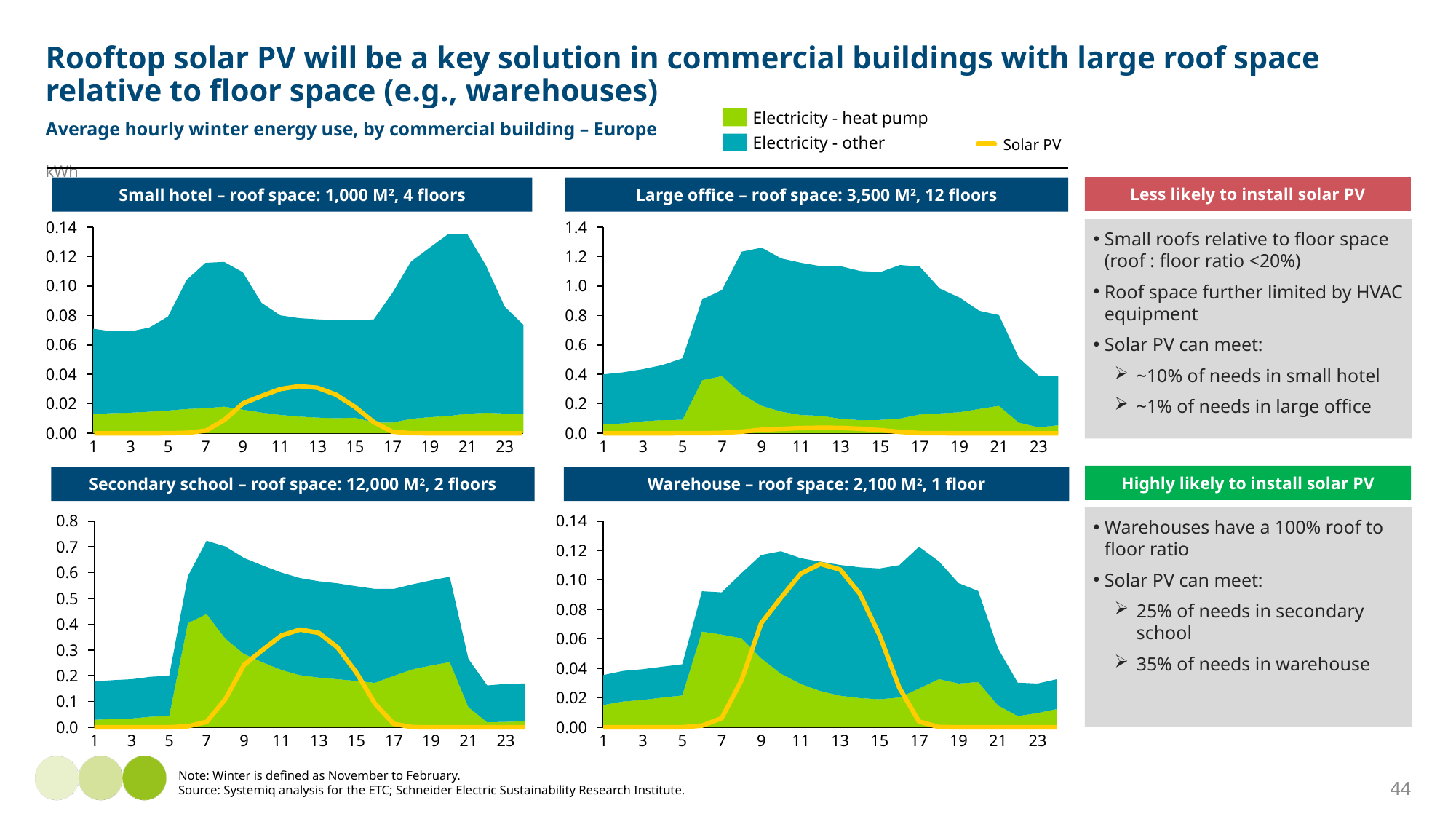
How many series does the legend list? 3 In the Warehouse chart, is the peak of the Solar PV line greater or less than 0.08? greater In the Secondary school chart, is the peak of the Solar PV line greater or less than 0.3? greater Which of the four buildings has the highest peak total electricity use? Large office In the Large office chart, is the peak total electricity use greater or less than 1.0? greater In the Large office chart, does total electricity use rise or fall between hour 17 and hour 23? fall Which has a higher peak total electricity use: the Large office or the Secondary school? Large office What roof space is stated in the title of the Warehouse chart? 2,100 M² In the Small hotel chart, does total electricity use rise or fall between hour 17 and hour 21? rise What kind of chart is used for the Small hotel panel? Stacked area chart with a line overlay